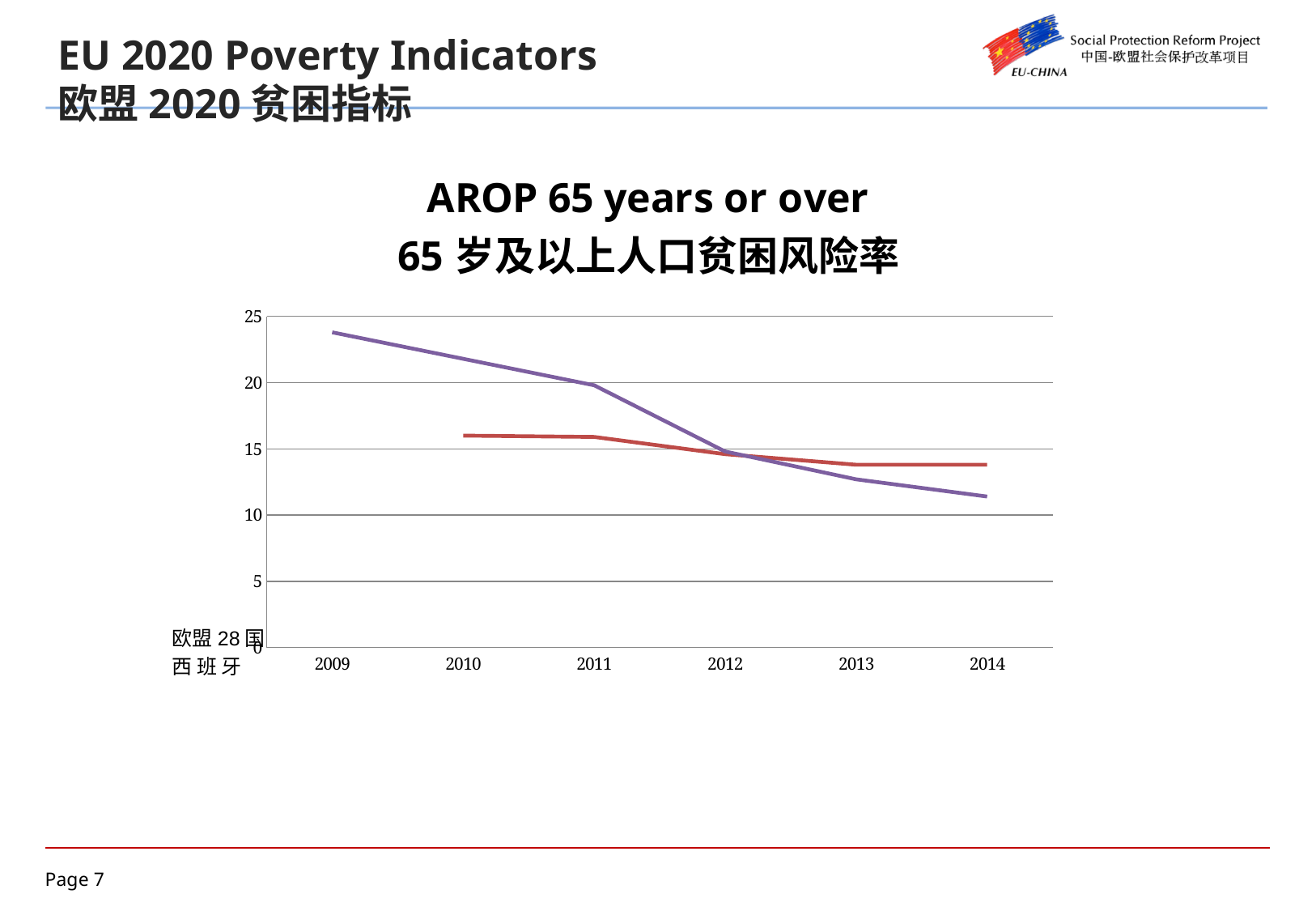
Is the value of the red line in 2014 greater or less than 15? less In 2014, which line has the higher value, the purple line or the red line? red line In 2011, which line has the higher value, the purple line or the red line? purple line Does the red line rise or fall from 2010 to 2014? fall In which year does the purple line reach its highest value? 2009 Is the value of the purple line in 2009 greater or less than 20? greater Is the value of the purple line in 2014 greater or less than 15? less What is the English title of the chart? AROP 65 years or over Does the purple line rise or fall from 2009 to 2014? fall What kind of chart is shown on the slide? line chart How many years are shown on the x axis of the chart? 6